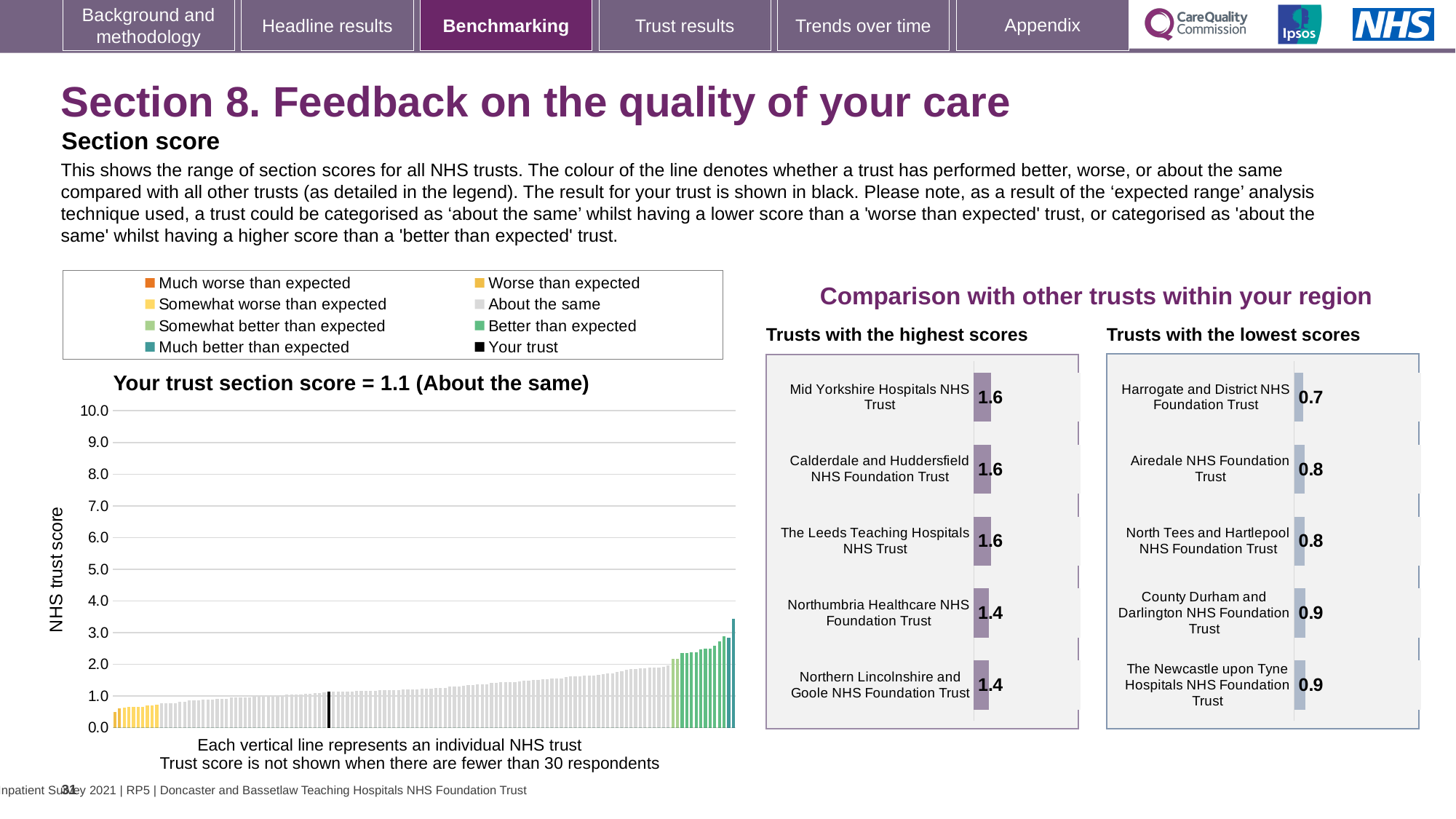
In the 'Your trust section score' chart, do the trust scores rise or fall from left to right along the x axis? rise Which has the larger score: Mid Yorkshire Hospitals NHS Trust in the 'Trusts with the highest scores' chart or Airedale NHS Foundation Trust in the 'Trusts with the lowest scores' chart? Mid Yorkshire Hospitals NHS Trust In the 'Your trust section score' chart, what kind of chart is shown? bar chart In the 'Your trust section score' chart, what is the label of the y axis? NHS trust score In the 'Trusts with the highest scores' chart, what is the score for Northumbria Healthcare NHS Foundation Trust? 1.4 In the 'Your trust section score' chart, is the highest trust score greater or less than 4.0? less How many entries does the legend above the 'Your trust section score' chart list? 8 In the 'Trusts with the highest scores' chart, what is the difference between the scores of Mid Yorkshire Hospitals NHS Trust and Northern Lincolnshire and Goole NHS Foundation Trust? 0.2 In the 'Trusts with the lowest scores' chart, which trust has the lowest score? Harrogate and District NHS Foundation Trust In the 'Your trust section score' chart, what is the section score for your trust? 1.1 In the 'Trusts with the lowest scores' chart, what is the score for County Durham and Darlington NHS Foundation Trust? 0.9 In the 'Trusts with the highest scores' chart, how many trusts are shown? 5